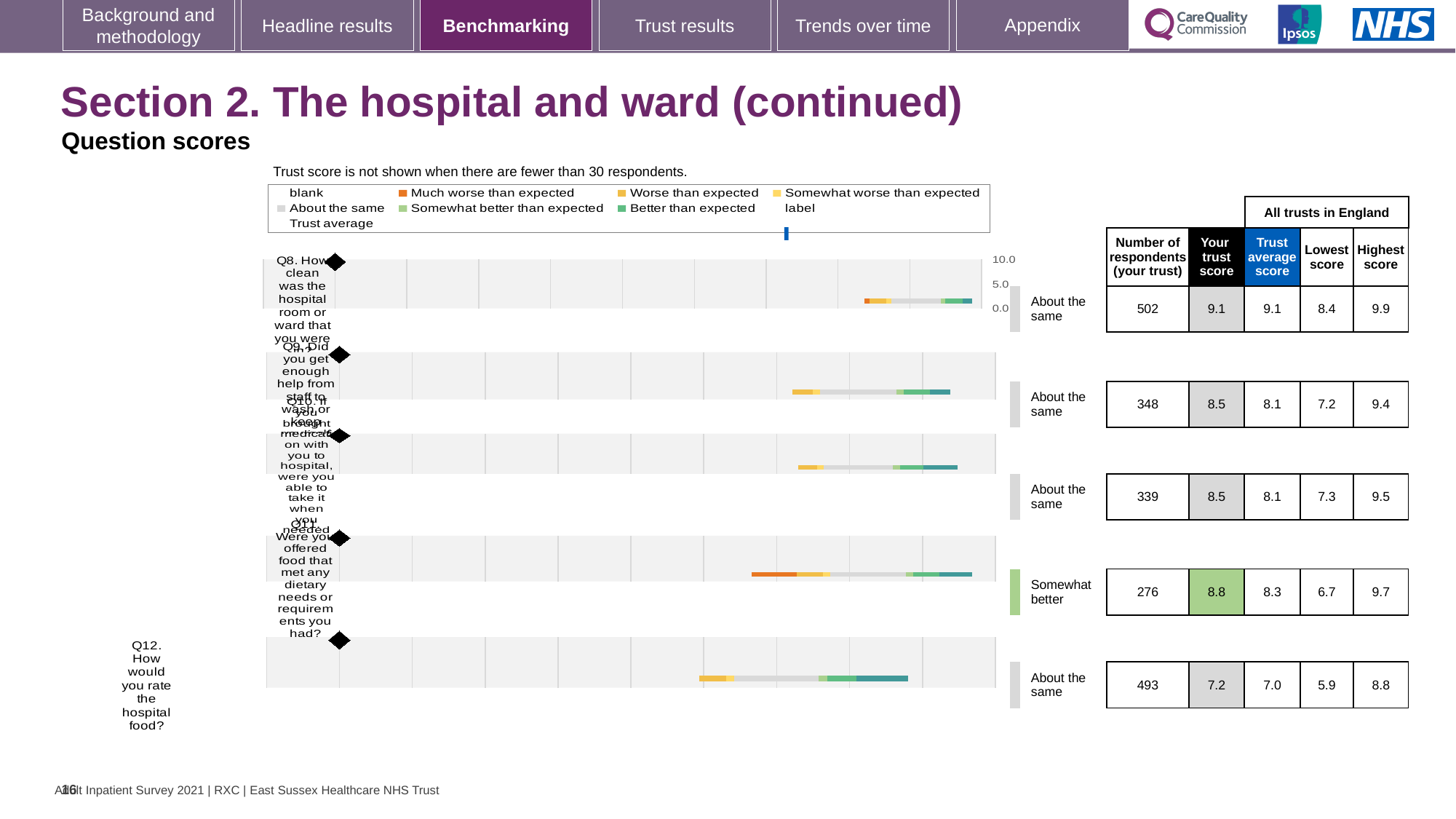
How many questions (Q8 to Q12) are plotted on the chart? 5 Which question has the highest trust score? Q8 What is the difference between the trust score and the trust average score for Q11? 0.5 Which has the larger trust score, Q9 or Q12? Q9 What is the highest score across all trusts in England for Q12? 8.8 Which question is rated 'Somewhat better' rather than 'About the same'? Q11 How many respondents answered Q12 (how would you rate the hospital food)? 493 Which question has the lowest trust score? Q12 What is the trust score for Q8 (how clean was the hospital room or ward)? 9.1 What kind of chart is used to show the question scores on this slide? bar chart What is the difference between the highest score and the lowest score for Q8? 1.5 What is the lowest score across all trusts in England for Q11? 6.7